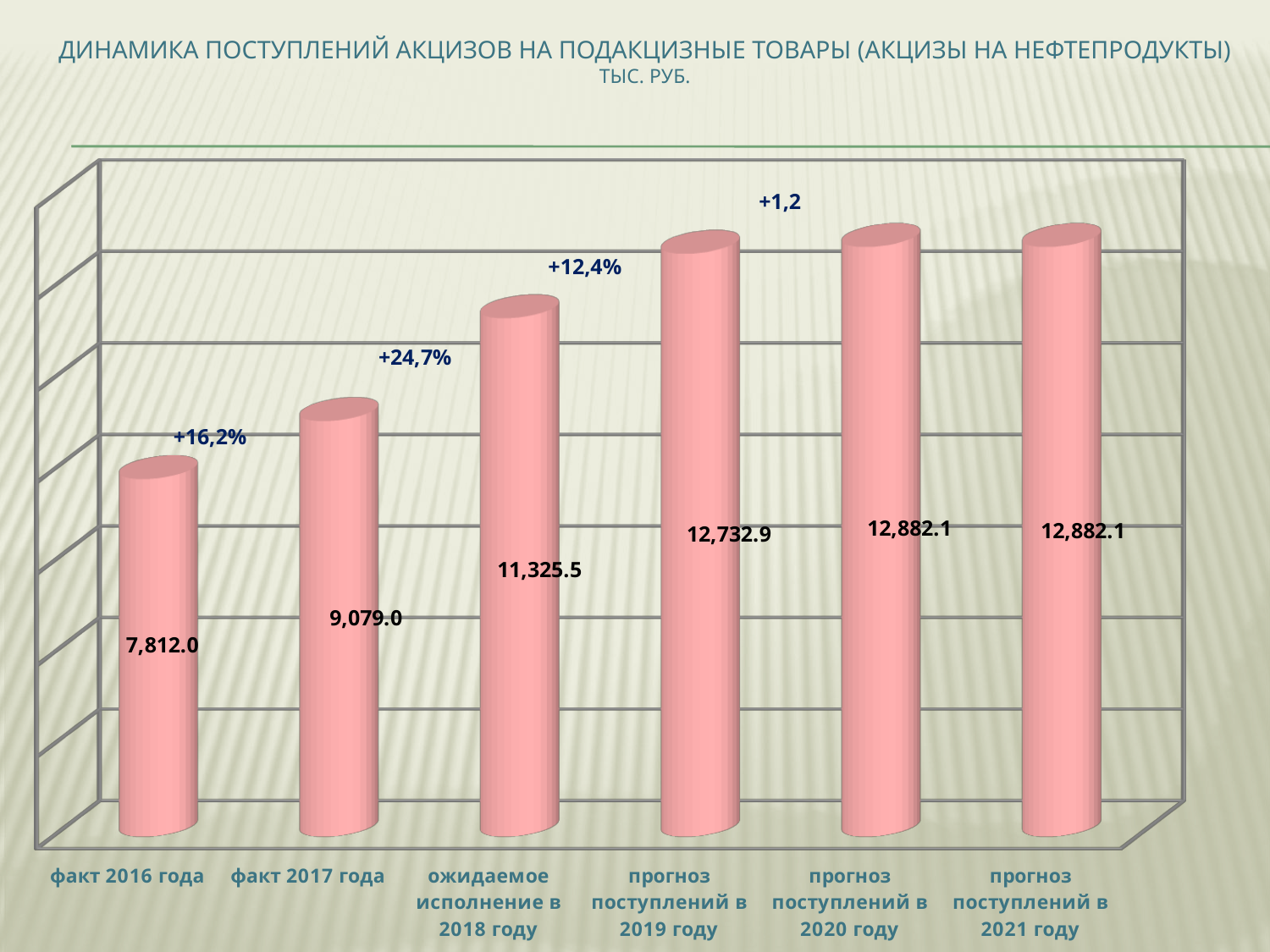
Which is larger, the value for ожидаемое исполнение в 2018 году or the value for факт 2017 года? ожидаемое исполнение в 2018 году What is the value for факт 2016 года? 7,812.0 What is the value for факт 2017 года? 9,079.0 What is the value for прогноз поступлений в 2019 году? 12,732.9 What is the difference between the values for прогноз поступлений в 2020 году and прогноз поступлений в 2019 году? 149.2 What is the difference between the values for факт 2017 года and факт 2016 года? 1,267.0 What is the value for ожидаемое исполнение в 2018 году? 11,325.5 How many categories are shown on the chart? 6 What is the highest value shown on the chart? 12,882.1 Which category has the lowest value? факт 2016 года What kind of chart is shown on the slide? bar chart What is the value for прогноз поступлений в 2021 году? 12,882.1